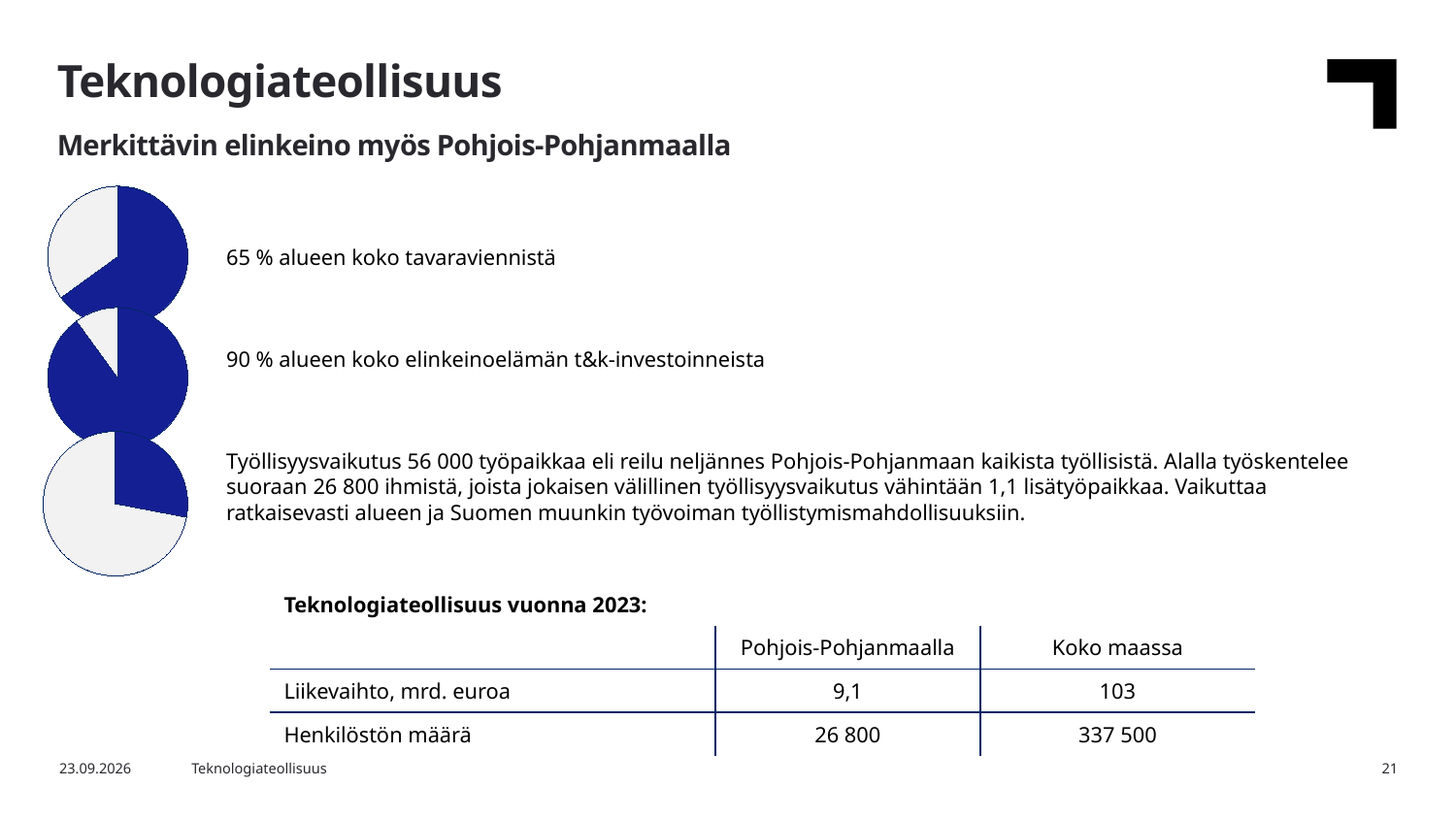
According to the text next to the middle pie chart, what share of the region's business R&D investments does the technology industry account for? 90 % According to the text next to the top pie chart, what share of the region's total goods exports does the technology industry account for? 65 % Which of the three pie charts has the smallest blue slice? The bottom one (employment share) How many pie charts are on the slide? 3 Do the pie charts have a legend? No Is the blue slice in the bottom pie chart greater or less than half of the pie? Less Which of the three pie charts has the largest blue slice? The middle one (90 % of R&D investments) Is the blue slice in the top pie chart larger or smaller than the blue slice in the bottom pie chart? Larger What two colours are used for the slices in the pie charts? Dark blue and light grey What kind of charts are shown on the left side of the slide? Pie charts Is the blue slice in the middle pie chart greater or less than half of the pie? Greater